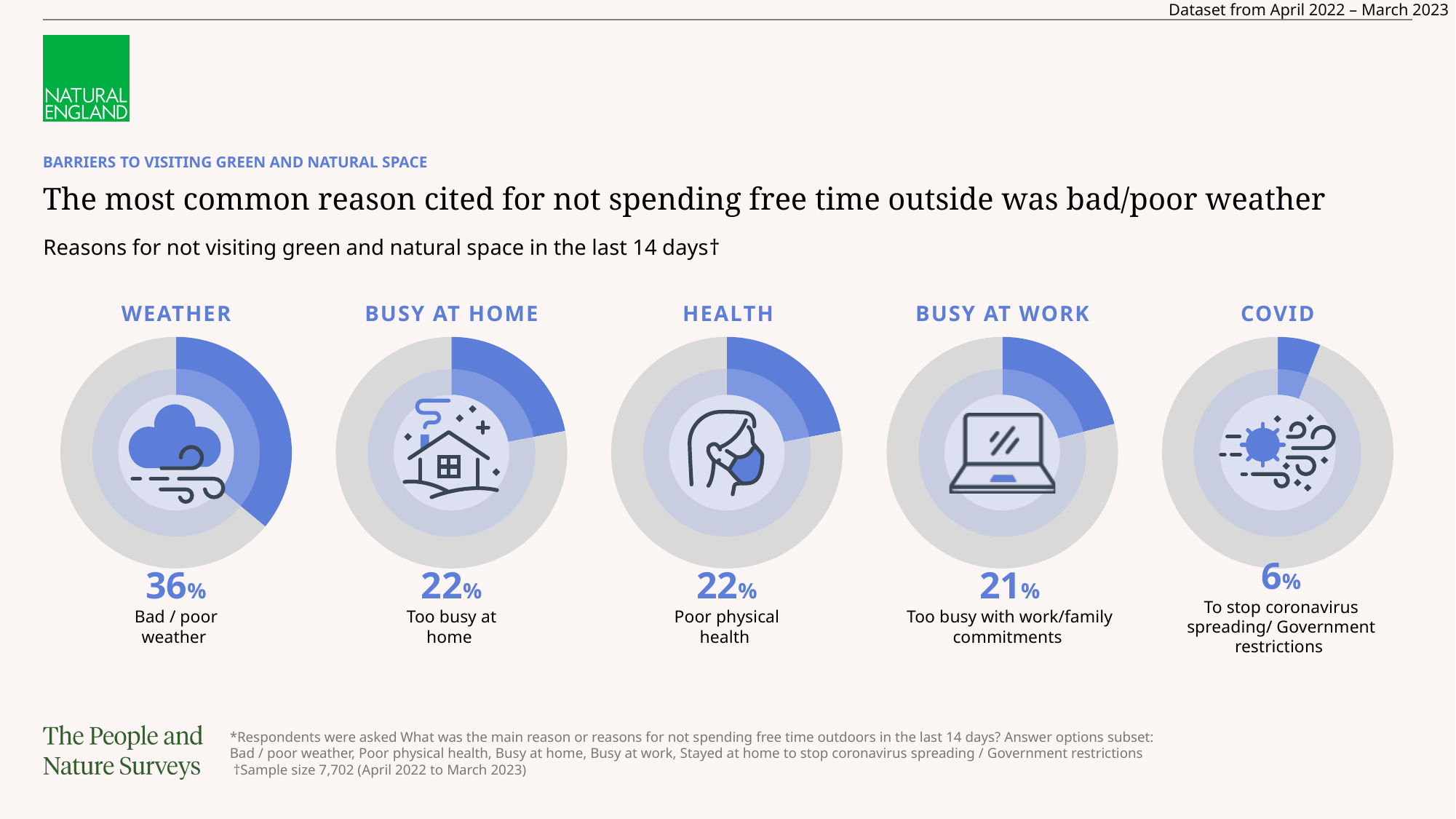
Which is larger, the value for Busy at Home or the value for Covid? Busy at Home What percentage is shown for the Health chart (poor physical health)? 22% What percentage is shown for the Busy at Home chart? 22% Which reason has the highest percentage across the five charts? Weather What percentage is shown for the Covid chart? 6% What percentage of respondents cited bad/poor weather as a reason for not visiting green and natural space? 36% Which reason has the lowest percentage across the five charts? Covid What is the difference in percentage points between the Weather chart and the Covid chart? 30 How many reasons (charts) are shown on the slide? 5 What is the difference in percentage points between the Weather chart and the Busy at Work chart? 15 What percentage of respondents cited being too busy with work/family commitments? 21% What kind of chart is used to show each reason on the slide? Donut (pie) chart